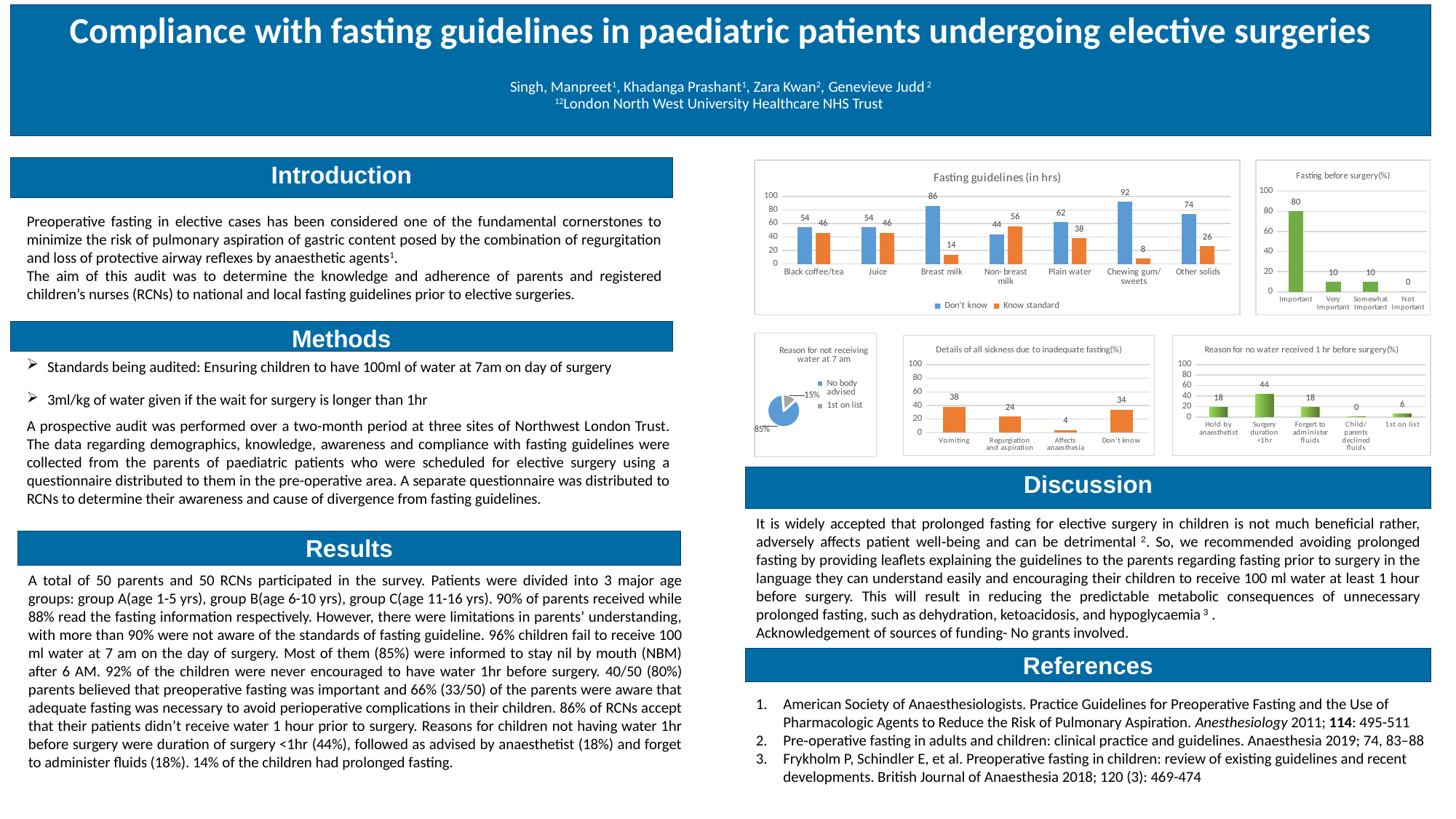
In the 'Fasting guidelines (in hrs)' chart, what is the difference between the 'Don't know' and 'Know standard' values for Plain water? 24 In the 'Reason for no water received 1 hr before surgery(%)' chart, which category has the highest value? Surgery duration <1hr In the 'Reason for not receiving water at 7 am' pie chart, what share is 'No body advised'? 85% In the 'Fasting guidelines (in hrs)' chart, which category has the highest 'Don't know' value? Chewing gum/ sweets In the 'Fasting guidelines (in hrs)' chart, which is larger for Non-breast milk: 'Don't know' or 'Know standard'? Know standard In the 'Fasting before surgery(%)' chart, what is the value for Important? 80 How many series does the legend of the 'Fasting guidelines (in hrs)' chart list? 2 In the 'Fasting before surgery(%)' chart, which category has the lowest value? Not Important How many categories are shown in the 'Reason for no water received 1 hr before surgery(%)' chart? 5 What kind of chart is 'Reason for not receiving water at 7 am'? Pie chart In the 'Details of all sickness due to inadequate fasting(%)' chart, what is the value for Vomiting? 38 In the 'Fasting guidelines (in hrs)' chart, what is the 'Don't know' value for Breast milk? 86